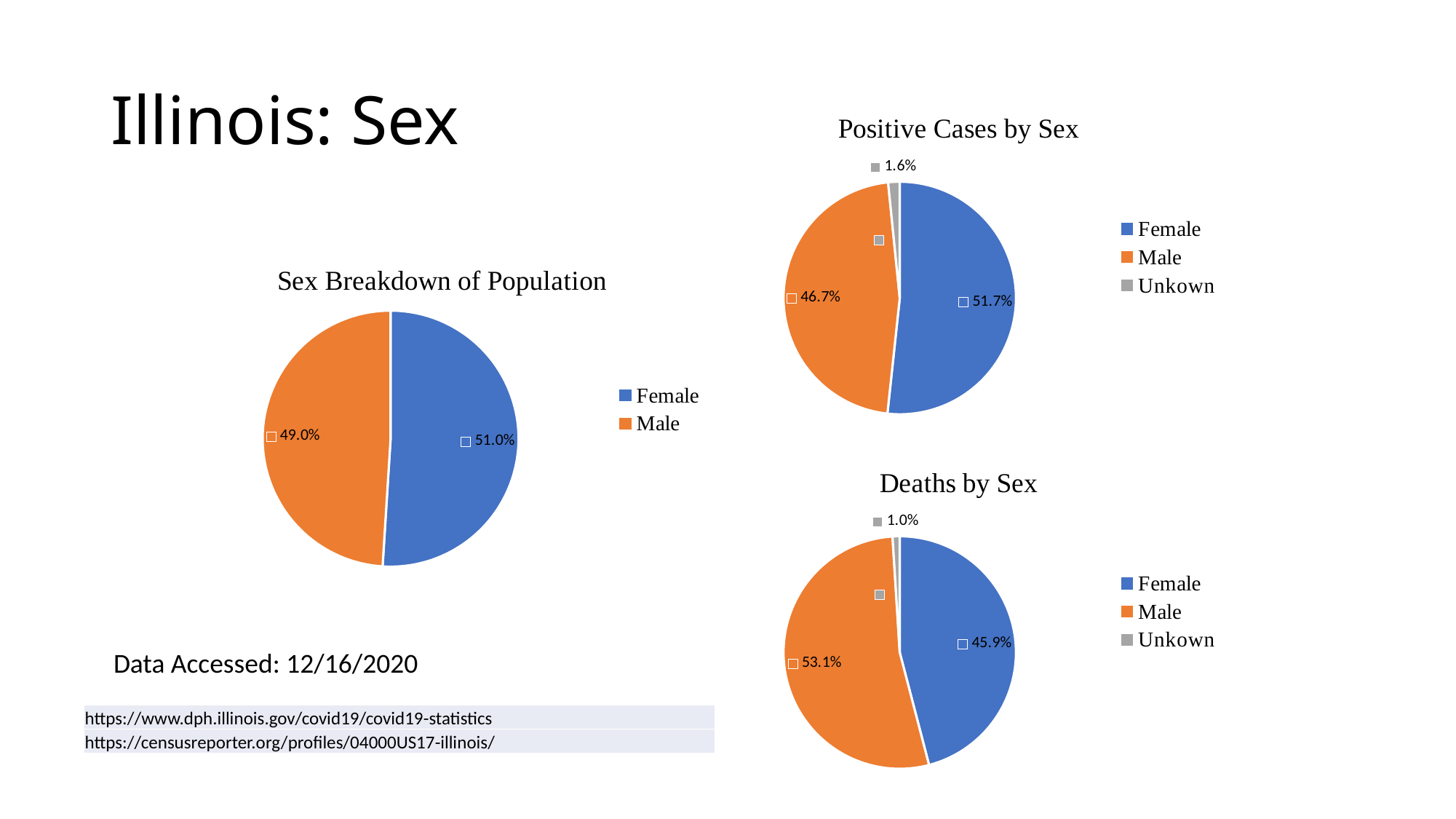
How many categories does the legend of the 'Deaths by Sex' chart list? 3 In the 'Deaths by Sex' chart, what is the difference between the Male and Female shares? 7.2% In the 'Positive Cases by Sex' chart, which is larger, the Female share or the Male share? Female In the 'Deaths by Sex' chart, what percentage of deaths are Female? 45.9% What colour represents Male in the 'Positive Cases by Sex' chart? Orange In the 'Sex Breakdown of Population' chart, what share of the population is Male? 49.0% In the 'Positive Cases by Sex' chart, what percentage of positive cases are Unkown? 1.6% In the 'Deaths by Sex' chart, which category has the largest share? Male In the 'Positive Cases by Sex' chart, which category has the smallest share? Unkown In the 'Sex Breakdown of Population' chart, what share of the population is Female? 51.0% What kind of chart is 'Sex Breakdown of Population'? Pie chart In the 'Positive Cases by Sex' chart, what percentage of positive cases are Male? 46.7%